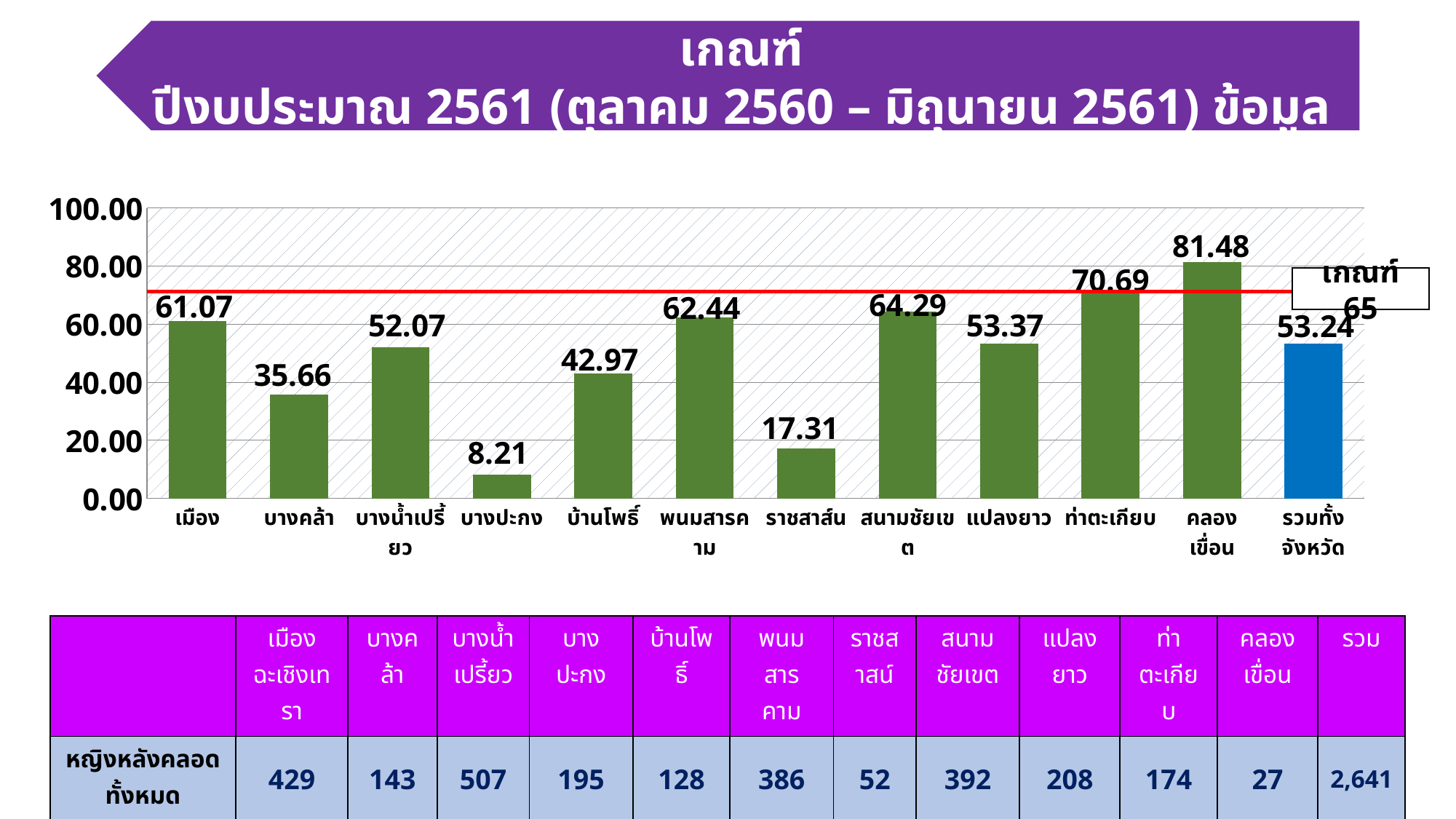
What is the value for รวมทั้งจังหวัด? 53.24 What kind of chart is shown on the slide? bar chart Which is larger, the value for เมือง or the value for พนมสารคาม? พนมสารคาม What threshold value is marked by the red horizontal line? 65 What is the value for คลองเขื่อน? 81.48 Which category has the highest value? คลองเขื่อน Is the value for ราชสาส์น greater or less than 20.00? less What is the value for บางปะกง? 8.21 Which bar is coloured blue instead of green? รวมทั้งจังหวัด Which category has the lowest value? บางปะกง What is the difference between the values for คลองเขื่อน and ท่าตะเกียบ? 10.79 How many bars are shown in the chart? 12